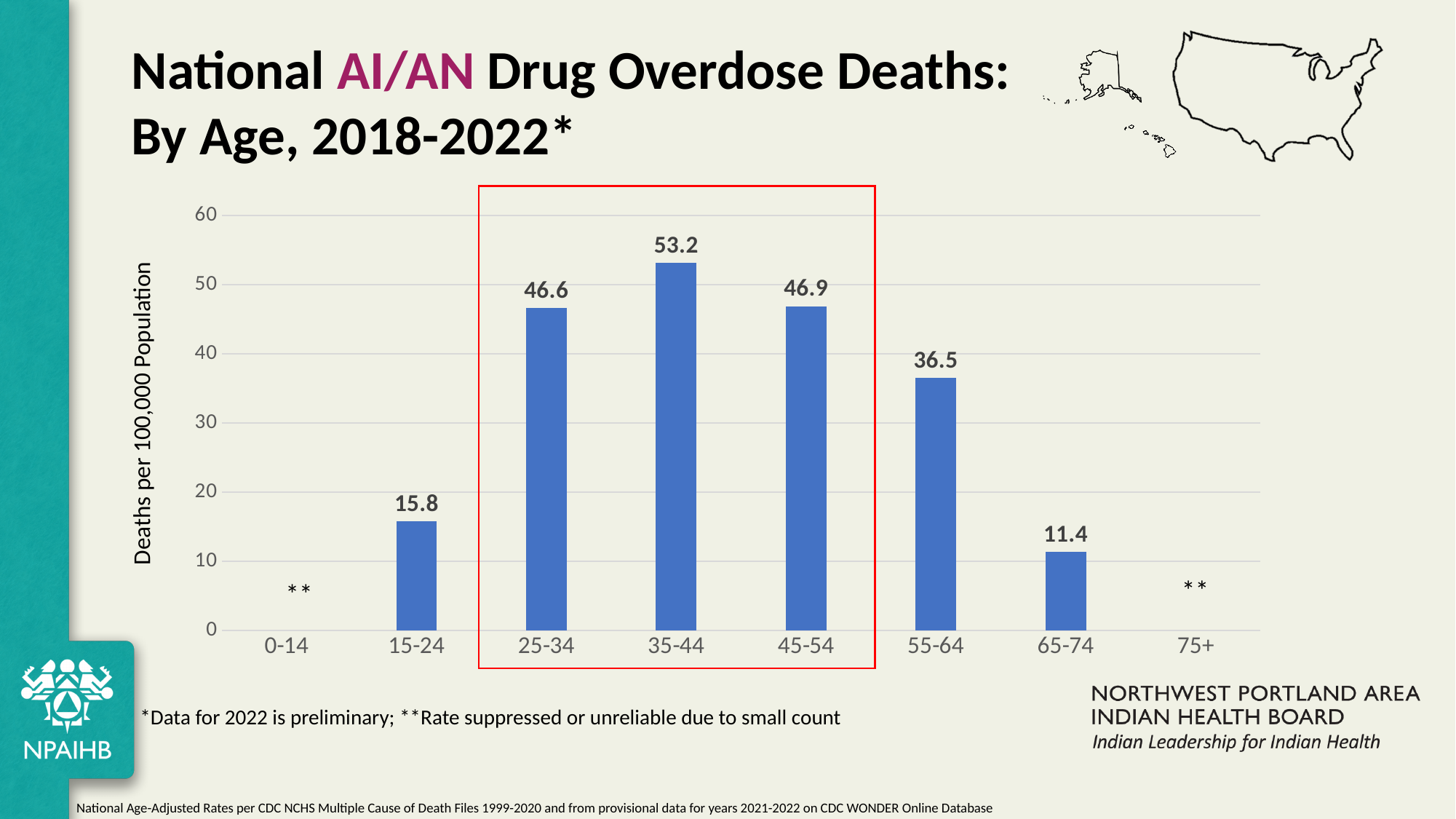
How many age group categories are shown on the x axis? 8 Which age group has the highest drug overdose death rate? 35-44 What is the drug overdose death rate for the 35-44 age group? 53.2 What is the difference between the rates for the 45-54 and 25-34 age groups? 0.3 What kind of chart is shown on the slide? bar chart Which is larger, the rate for 55-64 or the rate for 15-24? 55-64 Which age groups have their rate suppressed or unreliable due to small count? 0-14 and 75+ Is the value for the 55-64 age group greater or less than 40? less What is the difference between the rates for the 35-44 and 55-64 age groups? 16.7 Among the age groups with a plotted bar, which has the lowest rate? 65-74 What is the value shown for the 15-24 age group? 15.8 What is the value shown for the 65-74 age group? 11.4